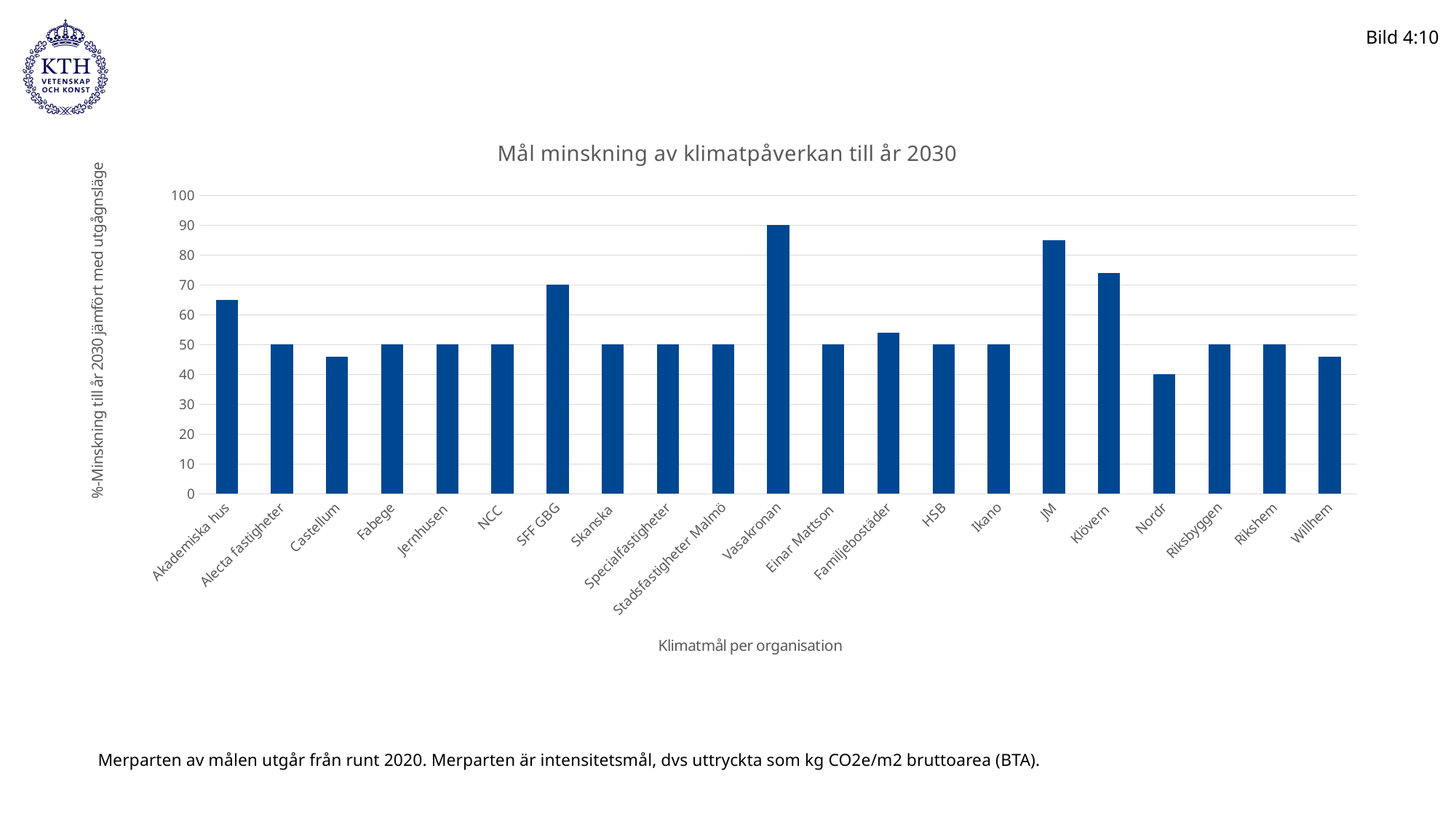
What is the value for Nordr? 40 What is the title of the chart? Mål minskning av klimatpåverkan till år 2030 What is the value for Vasakronan? 90 What is the value for Skanska? 50 What is the value for SFF GBG? 70 Which organisation has the lowest target reduction in the chart? Nordr Which organisation has the highest target reduction in the chart? Vasakronan Which is larger, the value for JM or the value for Klövern? JM What kind of chart is shown on the slide? Bar chart Is the value for JM greater or less than 80? greater What is the difference between the values for Vasakronan and SFF GBG? 20 How many organisations are shown on the x axis of the chart? 21